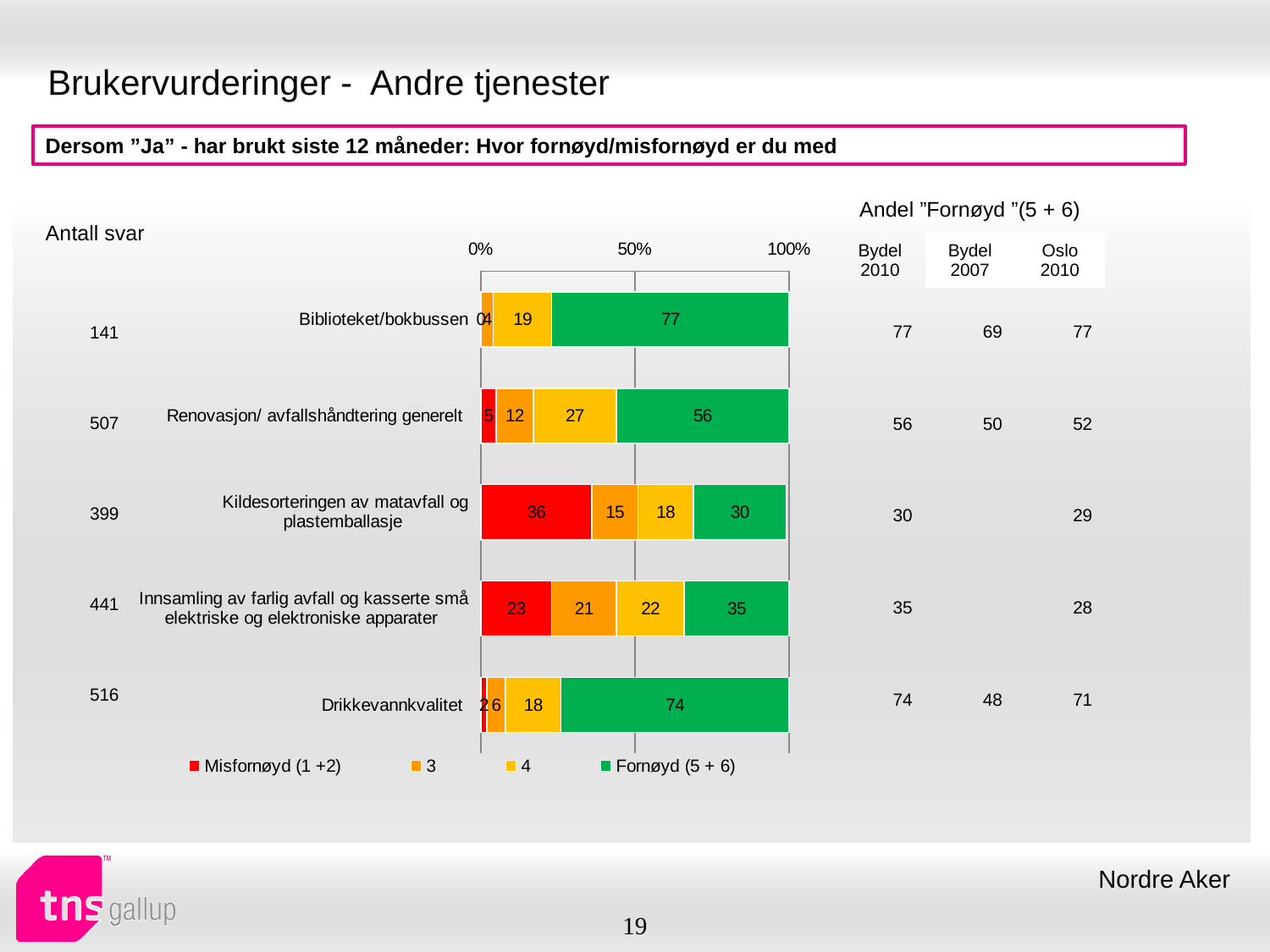
What is the value of the Fornøyd (5 + 6) segment for Biblioteket/bokbussen? 77 How many series does the legend list? 4 What is the value of the Misfornøyd (1 +2) segment for Kildesorteringen av matavfall og plastemballasje? 36 What is the difference between the Fornøyd (5 + 6) values for Renovasjon/ avfallshåndtering generelt and Kildesorteringen av matavfall og plastemballasje? 26 Which has the larger Misfornøyd (1 +2) value: Innsamling av farlig avfall og kasserte små elektriske og elektroniske apparater or Kildesorteringen av matavfall og plastemballasje? Kildesorteringen av matavfall og plastemballasje What kind of chart is shown on the slide? Stacked bar chart Which category has the lowest Fornøyd (5 + 6) value? Kildesorteringen av matavfall og plastemballasje How many categories are shown in the chart? 5 Which category has the highest Fornøyd (5 + 6) value? Biblioteket/bokbussen What is the value of the '4' segment for Renovasjon/ avfallshåndtering generelt? 27 What is the value of the '3' segment for Drikkevannkvalitet? 6 What is the first entry in the chart's legend? Misfornøyd (1 +2)